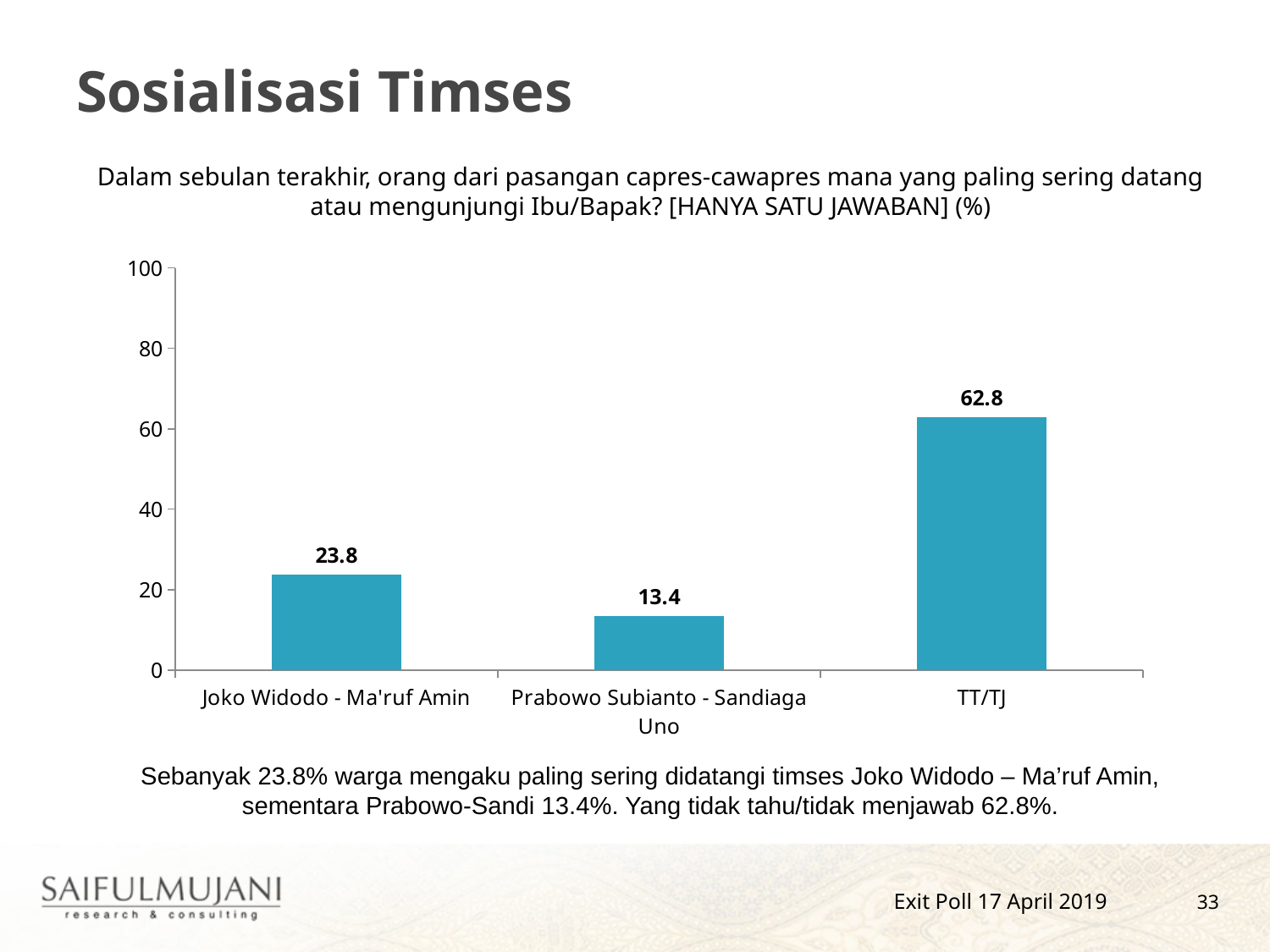
What is the value for Joko Widodo - Ma'ruf Amin? 23.8 What kind of chart is shown on the slide? bar chart What is the value for Prabowo Subianto - Sandiaga Uno? 13.4 Which category has the lowest value? Prabowo Subianto - Sandiaga Uno What is the maximum value shown on the y axis? 100 How many categories are shown on the x axis? 3 Which category has the highest value? TT/TJ What is the difference between the values for Joko Widodo - Ma'ruf Amin and Prabowo Subianto - Sandiaga Uno? 10.4 Which is larger, the value for Joko Widodo - Ma'ruf Amin or the value for Prabowo Subianto - Sandiaga Uno? Joko Widodo - Ma'ruf Amin What is the difference between the values for TT/TJ and Joko Widodo - Ma'ruf Amin? 39.0 Is the value for TT/TJ greater or less than 60? greater What is the value for TT/TJ? 62.8